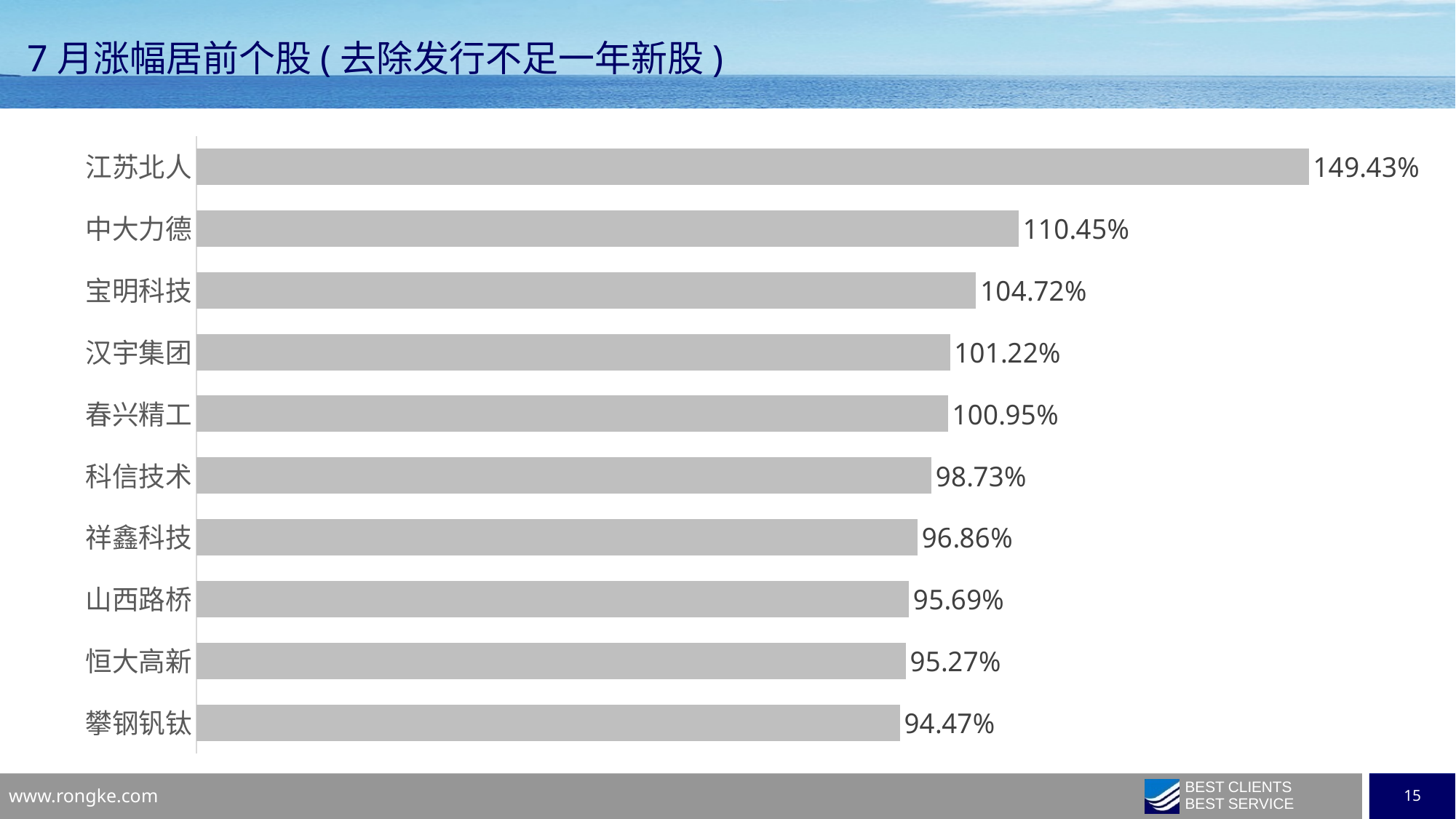
Which stock has the highest value? 江苏北人 Which stock has the lowest value? 攀钢钒钛 What kind of chart is shown on the slide? Bar chart What is the title of the slide? 7月涨幅居前个股（去除发行不足一年新股） Which is larger, the value for 中大力德 or the value for 祥鑫科技? 中大力德 What is the value for 汉宇集团? 101.22% What is the difference between the values for 宝明科技 and 科信技术? 5.99% What is the difference between the values for 江苏北人 and 中大力德? 38.98% What colour are the bars in the chart? Grey What is the value for 江苏北人? 149.43% What is the value for 攀钢钒钛? 94.47% How many stocks are shown in the chart? 10